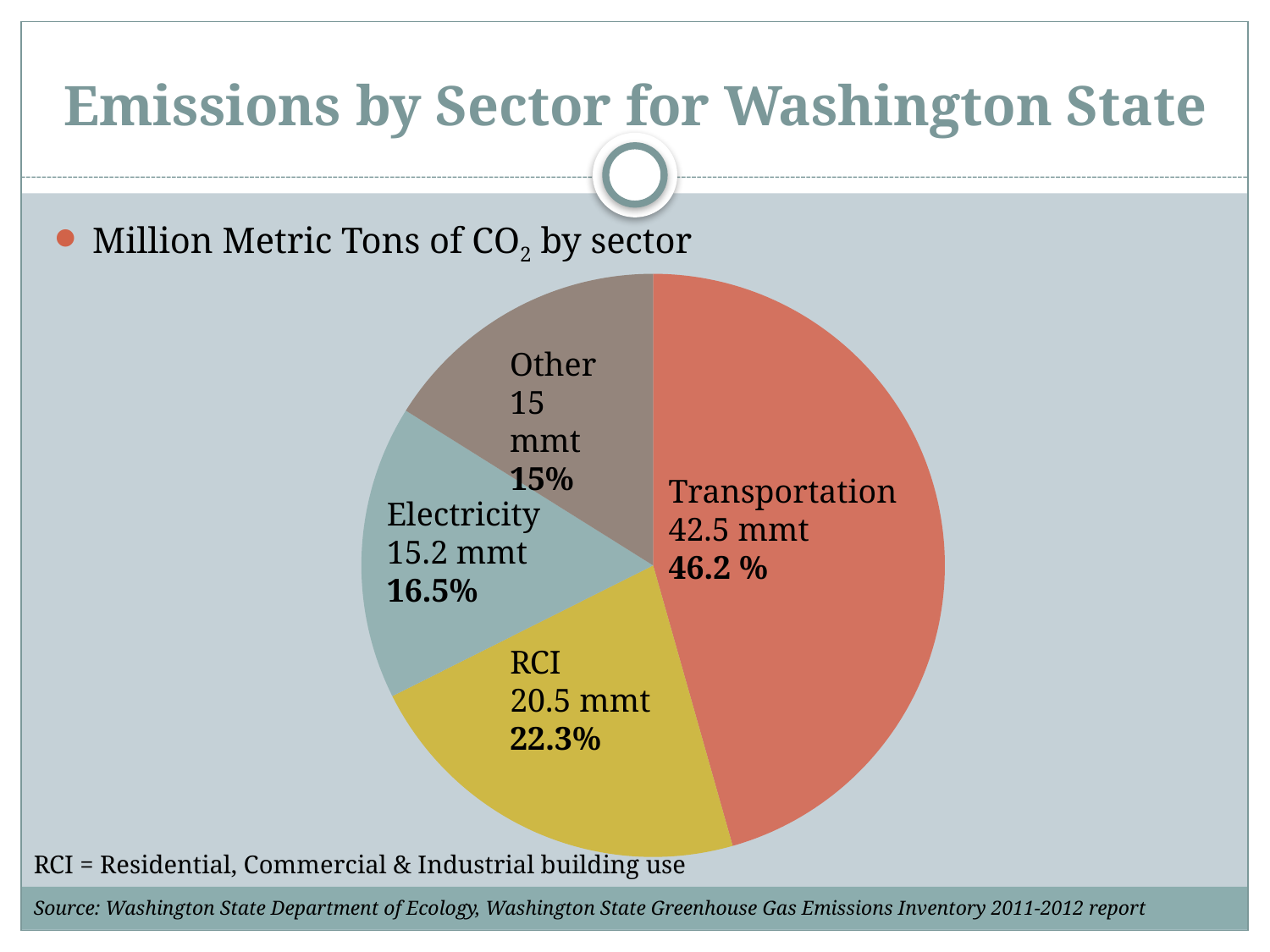
What kind of chart is shown on the slide? pie chart Which sector has higher emissions, Electricity or RCI? RCI What is the emissions value for RCI? 20.5 mmt What is the emissions value for Electricity? 15.2 mmt Which sector has the lowest emissions? Other Which sector has the highest emissions? Transportation What does RCI stand for according to the slide? Residential, Commercial & Industrial building use How many sectors (slices) does the pie chart show? 4 What is the emissions value for Transportation? 42.5 mmt What is the difference in emissions between Transportation and RCI? 22 mmt What percentage share of emissions does Transportation account for? 46.2 % What percentage share of emissions does the Other sector account for? 15%